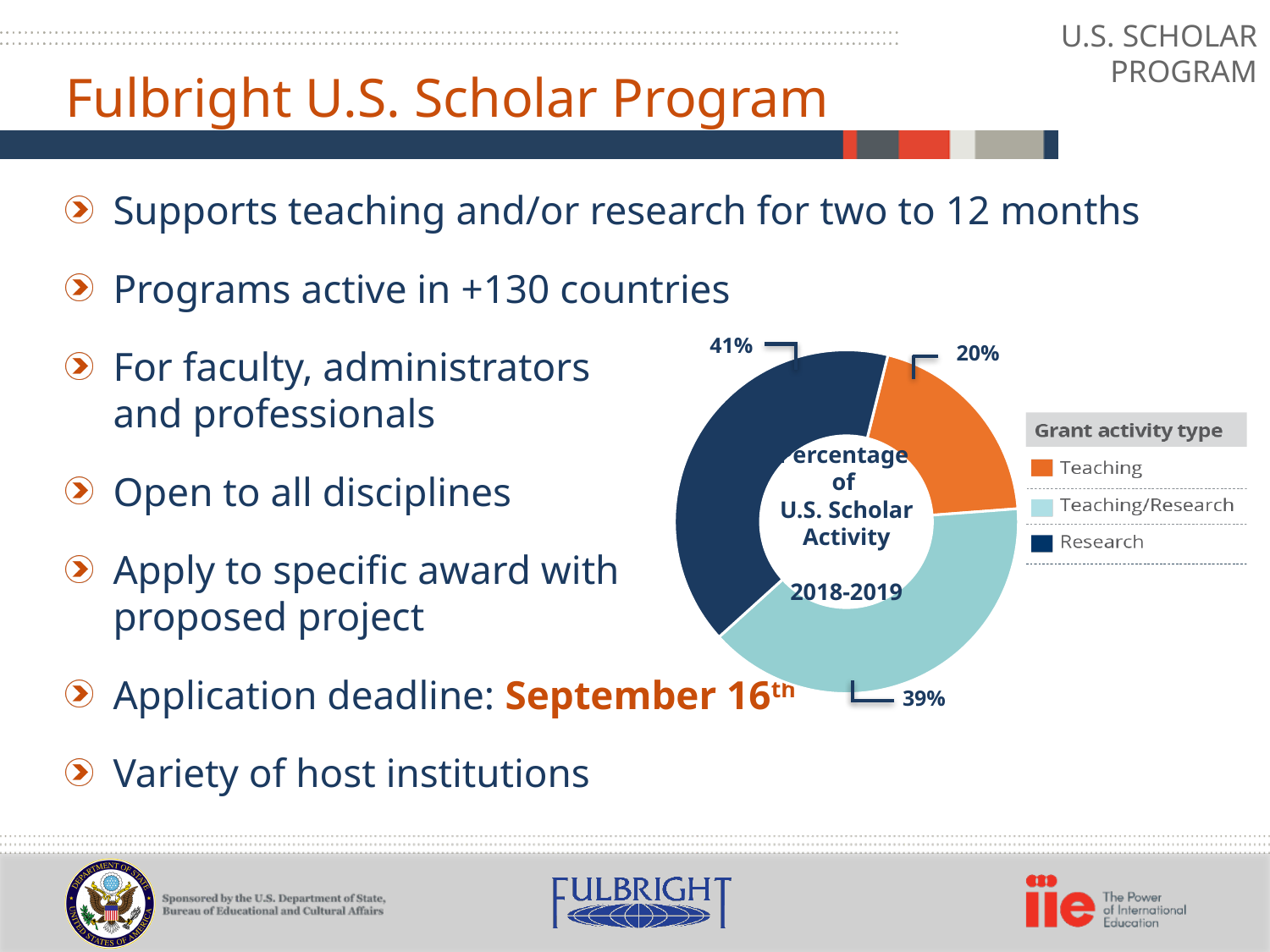
What is the title of the legend on the chart? Grant activity type Which grant activity type has the largest share of the chart? Research What percentage of U.S. Scholar activity in 2018-2019 was Teaching? 20% How many grant activity types are shown in the chart? 3 What percentage of U.S. Scholar activity in 2018-2019 was Teaching/Research? 39% What is the difference in percentage points between the Research and Teaching shares? 21 What kind of chart is shown on the slide? Donut (pie) chart Which grant activity type has the smallest share of the chart? Teaching What is the difference in percentage points between the Teaching/Research and Teaching shares? 19 Which is larger, the Teaching/Research share or the Teaching share? Teaching/Research Which year range does the chart cover? 2018-2019 What percentage of U.S. Scholar activity in 2018-2019 was Research? 41%